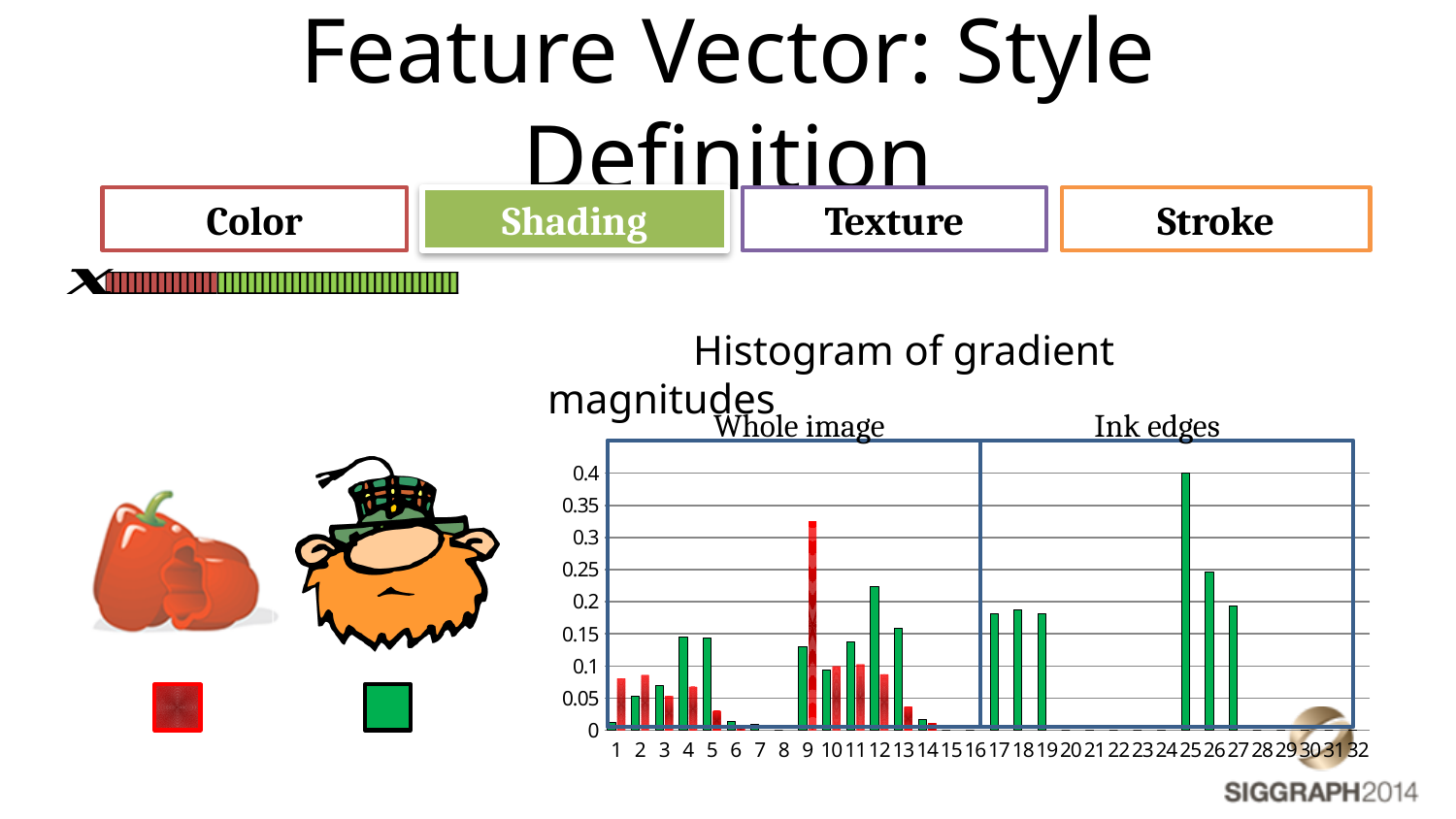
At which x-axis category is the tallest green bar? 25 At which x-axis category is the tallest red bar? 9 How many categories are labelled along the x axis of the chart? 32 Is the green bar at category 25 greater or less than 0.35? greater What are the two section labels printed above the chart? Whole image and Ink edges Is the red bar at category 1 greater or less than 0.1? less Is the green bar at category 26 greater or less than 0.2? greater What is the title of the chart? Histogram of gradient magnitudes At category 12, which bar is taller, the red one or the green one? green At category 9, which bar is taller, the red one or the green one? red What kind of chart is shown on the slide? bar chart